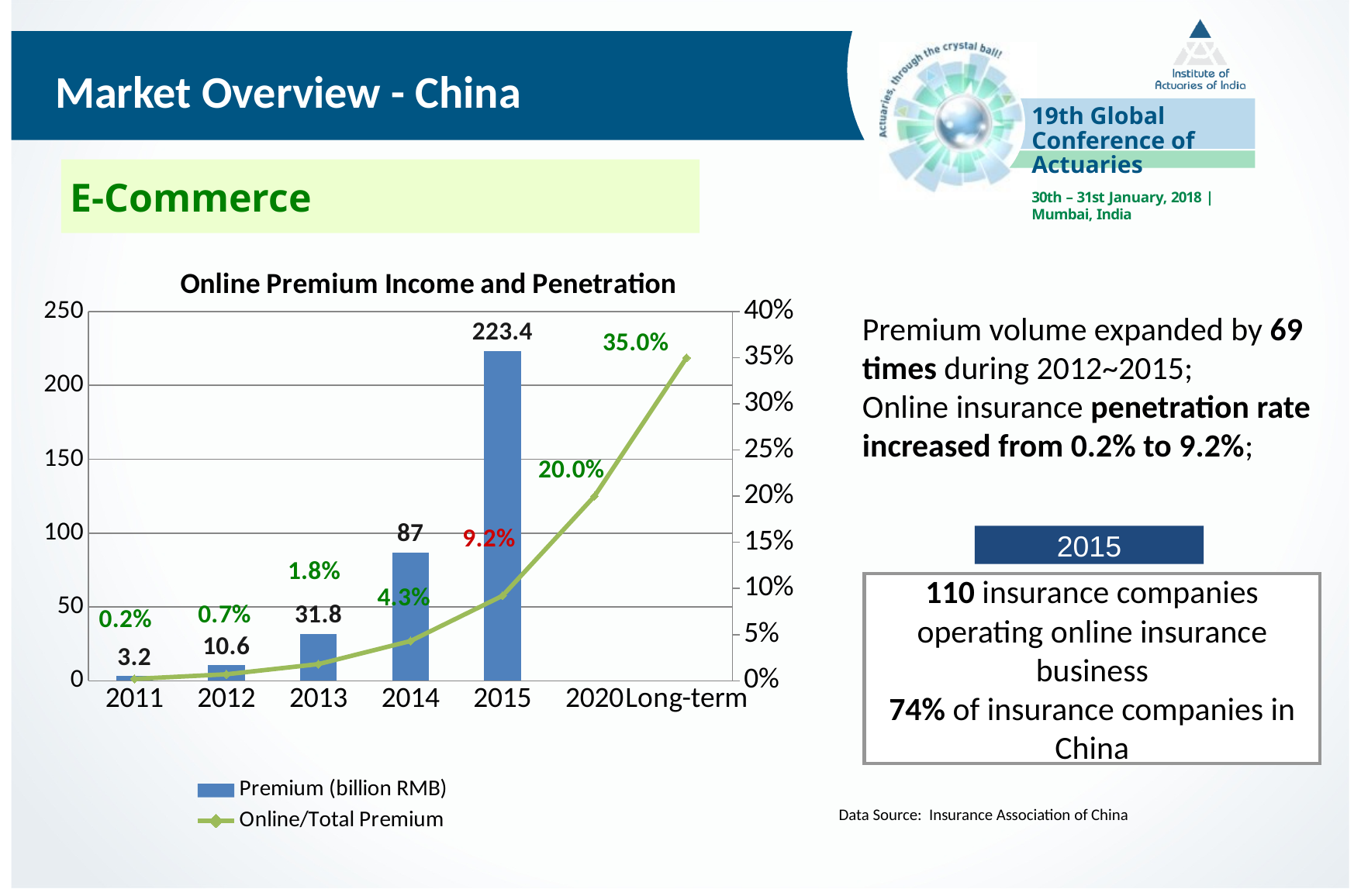
What is the Online/Total Premium value for Long-term? 35.0% How many series does the legend list? 2 Which year has the highest Premium (billion RMB) bar? 2015 Which category has the lowest Online/Total Premium value? 2011 Which is larger, the Premium (billion RMB) value for 2013 or for 2012? 2013 What is the Online/Total Premium value for 2014? 4.3% What is the Premium (billion RMB) value for 2015? 223.4 How many categories are shown on the x axis? 7 What is the difference between the Premium (billion RMB) values for 2015 and 2014? 136.4 Does the Online/Total Premium line rise or fall from 2011 to Long-term? rise Is the Premium (billion RMB) value for 2015 greater or less than 200? greater What is the title of the chart? Online Premium Income and Penetration